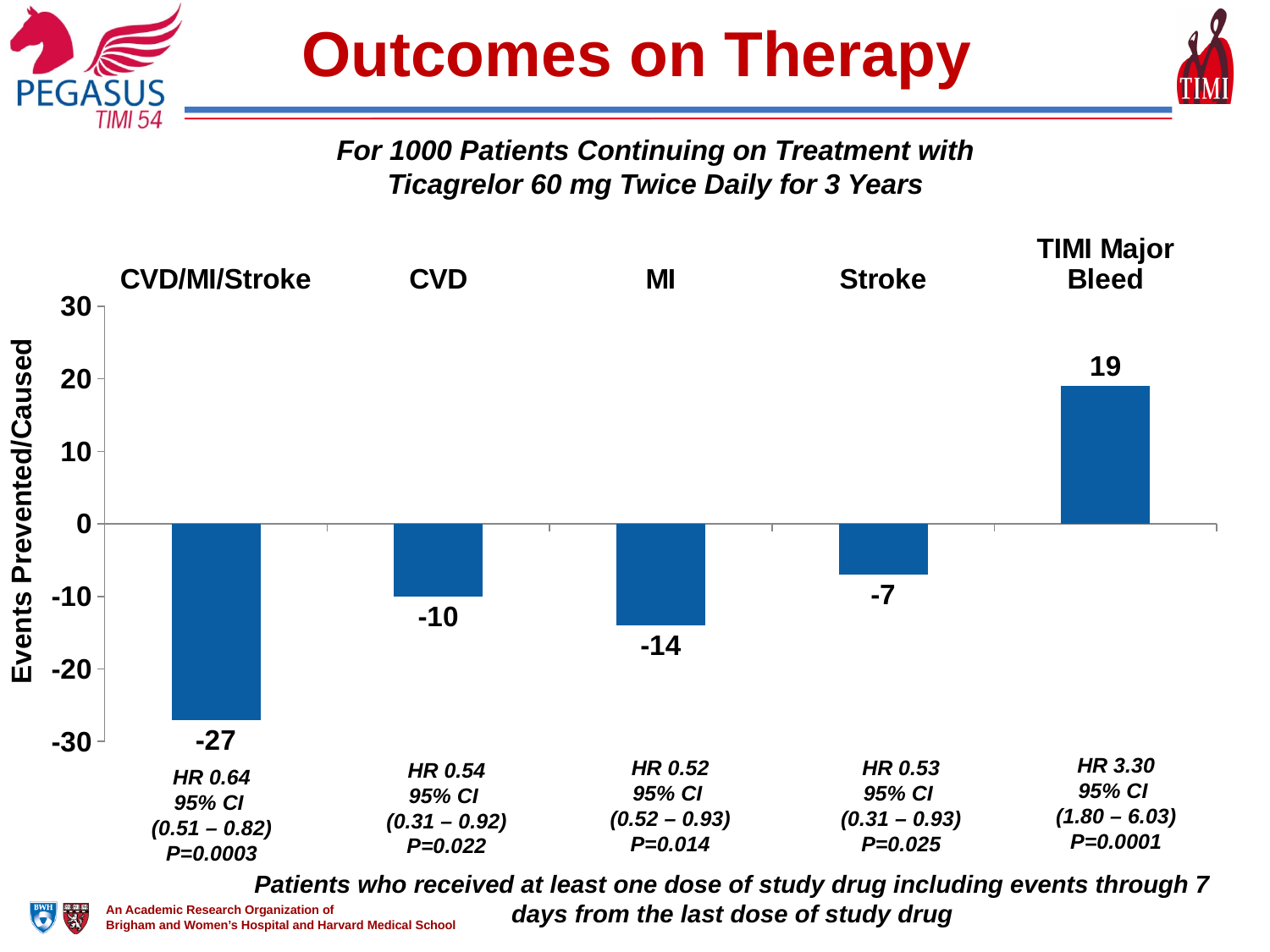
What kind of chart is shown on the slide? Bar chart What is the value for MI? -14 What is the value for CVD/MI/Stroke? -27 What is the difference between the values for CVD and MI? 4 Which category has the highest value? TIMI Major Bleed How many categories are shown in the chart? 5 Which category has the lowest value? CVD/MI/Stroke What is the label of the vertical axis? Events Prevented/Caused Which is larger, the value for CVD or the value for Stroke? Stroke What is the value for TIMI Major Bleed? 19 What is the hazard ratio shown under the TIMI Major Bleed bar? HR 3.30 What is the value for Stroke? -7